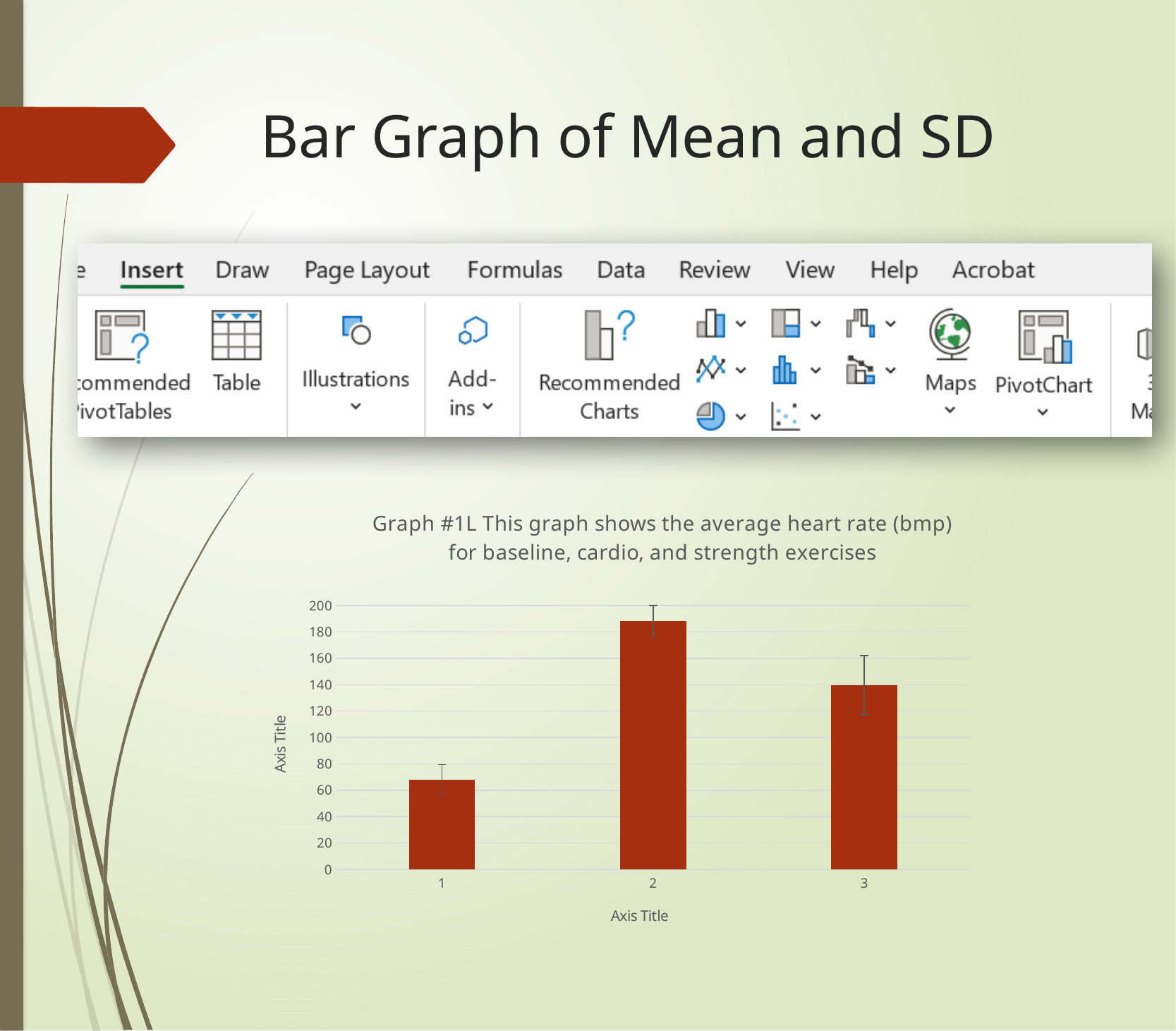
How many bars are plotted in the chart? 3 Which category has the highest bar? 2 Is the value for category 2 greater or less than 180? greater Is the value for category 1 greater or less than 60? greater What kind of chart is shown on the slide? bar chart What is the title of the chart? Graph #1L This graph shows the average heart rate (bmp) for baseline, cardio, and strength exercises Is the value for category 3 greater or less than 120? greater What is the highest value shown on the vertical axis of the chart? 200 Which is larger, the value for category 2 or the value for category 3? 2 Which category has the lowest bar? 1 Which is larger, the value for category 1 or the value for category 3? 3